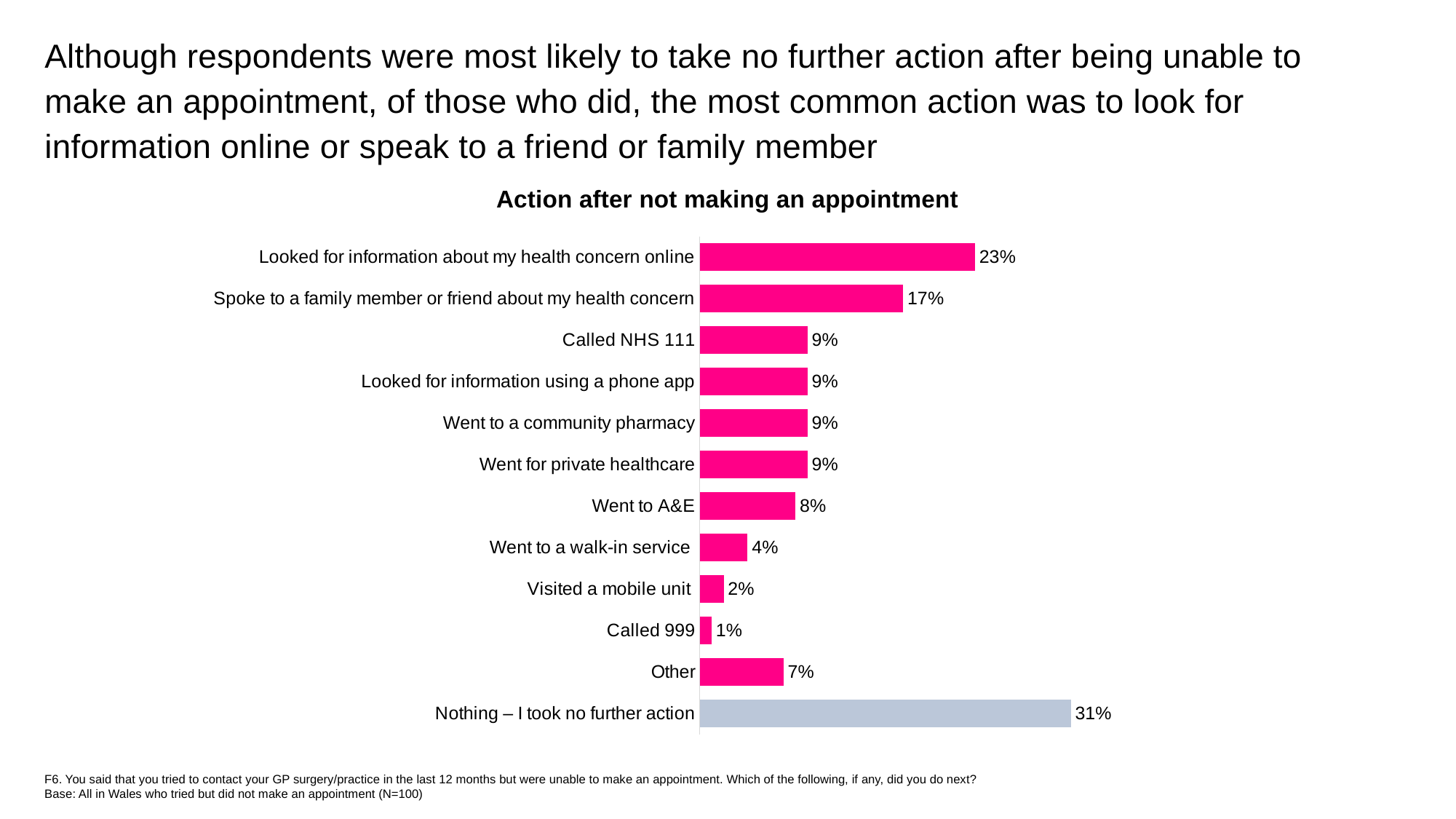
Which is larger: 'Went to A&E' or 'Went to a walk-in service'? Went to A&E Which category has the lowest value in the chart? Called 999 What percentage of respondents called 999? 1% Which category has the highest value in the chart? Nothing – I took no further action How many categories are shown in the chart? 12 What percentage of respondents looked for information about their health concern online? 23% What is the value for 'Went to a walk-in service'? 4% What type of chart is shown on the slide? Bar chart Which bar is coloured differently (grey) from the others? Nothing – I took no further action What is the value for 'Nothing – I took no further action'? 31% What is the title of the chart? Action after not making an appointment What is the difference between 'Looked for information about my health concern online' and 'Spoke to a family member or friend about my health concern'? 6%